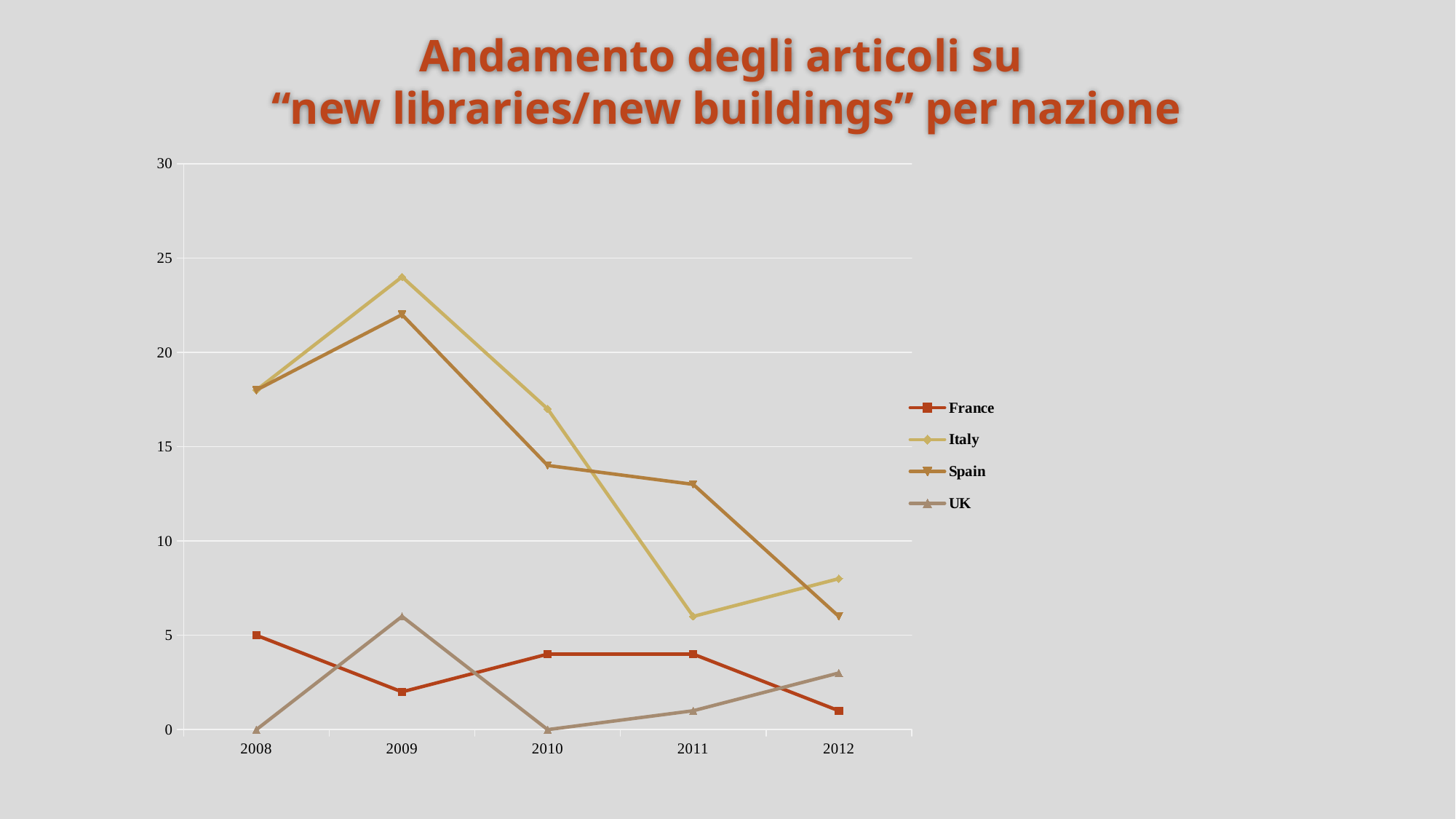
Which countries are listed in the legend? France, Italy, Spain, UK What is the value for UK in 2010? 0 How many years are shown on the x axis? 5 What kind of chart is shown on the slide? line chart Is the value for Spain in 2011 greater or less than 15? less Which country has the highest value in 2009? Italy How many series does the legend list? 4 What is the value for France in 2008? 5 Which country has the lowest value in 2010? UK In 2012, which is larger, the value for Italy or the value for Spain? Italy Does the value for Italy rise or fall from 2009 to 2011? fall Is the value for Italy in 2009 greater or less than 20? greater